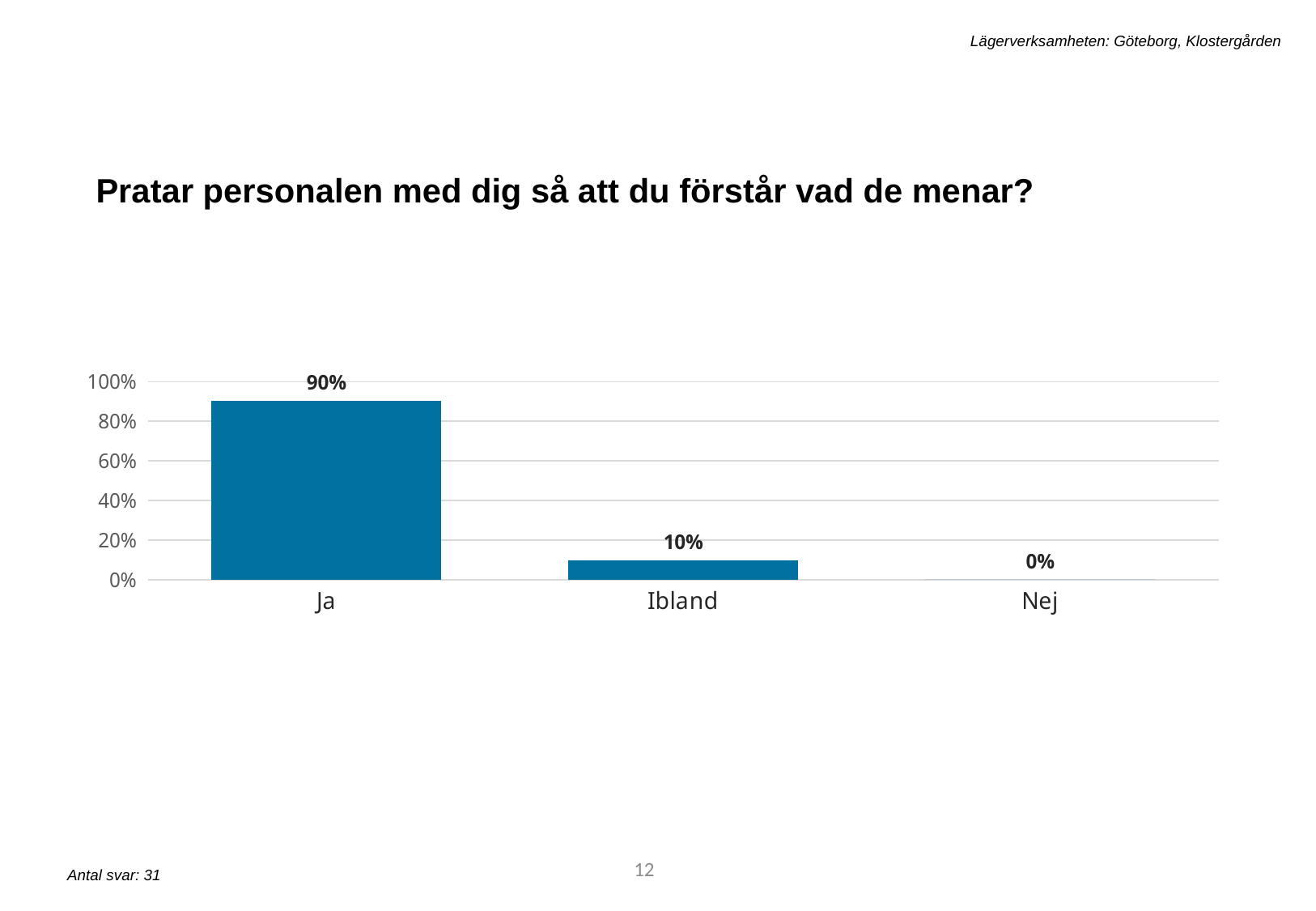
What is the value for Nej? 0% Which is larger, the value for Ibland or the value for Nej? Ibland How many categories are shown on the x axis? 3 Do the values rise or fall from left to right along the x axis? fall What is the title of the chart? Pratar personalen med dig så att du förstår vad de menar? Which category has the lowest value? Nej Is the value for Ja greater or less than 80%? greater What is the value for Ibland? 10% Which category has the highest value? Ja What kind of chart is shown on the slide? bar chart What is the difference between the values for Ja and Ibland? 80% What is the value for Ja? 90%